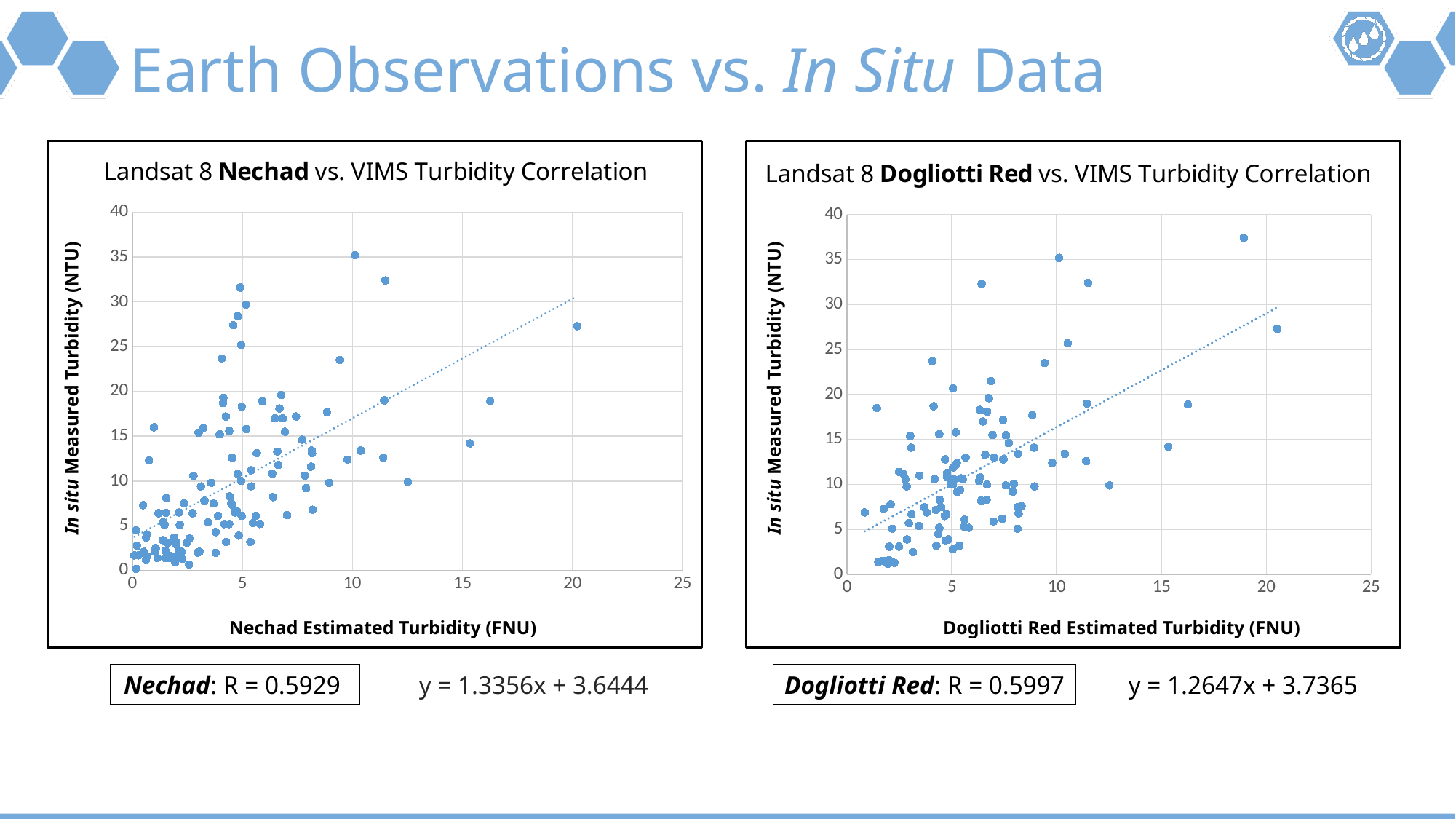
Which correlation has the higher R value, Nechad or Dogliotti Red? Dogliotti Red What is the y-axis label of the left-hand chart? In situ Measured Turbidity (NTU) In the Landsat 8 Dogliotti Red vs. VIMS Turbidity Correlation chart, does the trend line rise or fall as Dogliotti Red estimated turbidity increases? rise What is the trend line equation shown for the Landsat 8 Nechad vs. VIMS Turbidity Correlation chart? y = 1.3356x + 3.6444 In the Landsat 8 Nechad vs. VIMS Turbidity Correlation chart, is the highest in situ measured turbidity value greater or less than 30? greater In the Landsat 8 Dogliotti Red vs. VIMS Turbidity Correlation chart, is the highest in situ measured turbidity value greater or less than 35? greater What is the R value reported for the Dogliotti Red correlation? 0.5997 What is the trend line equation shown for the Landsat 8 Dogliotti Red vs. VIMS Turbidity Correlation chart? y = 1.2647x + 3.7365 What is the R value reported for the Nechad correlation? 0.5929 In the Landsat 8 Nechad vs. VIMS Turbidity Correlation chart, does the trend line rise or fall as Nechad estimated turbidity increases? rise What kind of chart is the Landsat 8 Nechad vs. VIMS Turbidity Correlation chart? scatter chart What is the x-axis label of the right-hand chart? Dogliotti Red Estimated Turbidity (FNU)